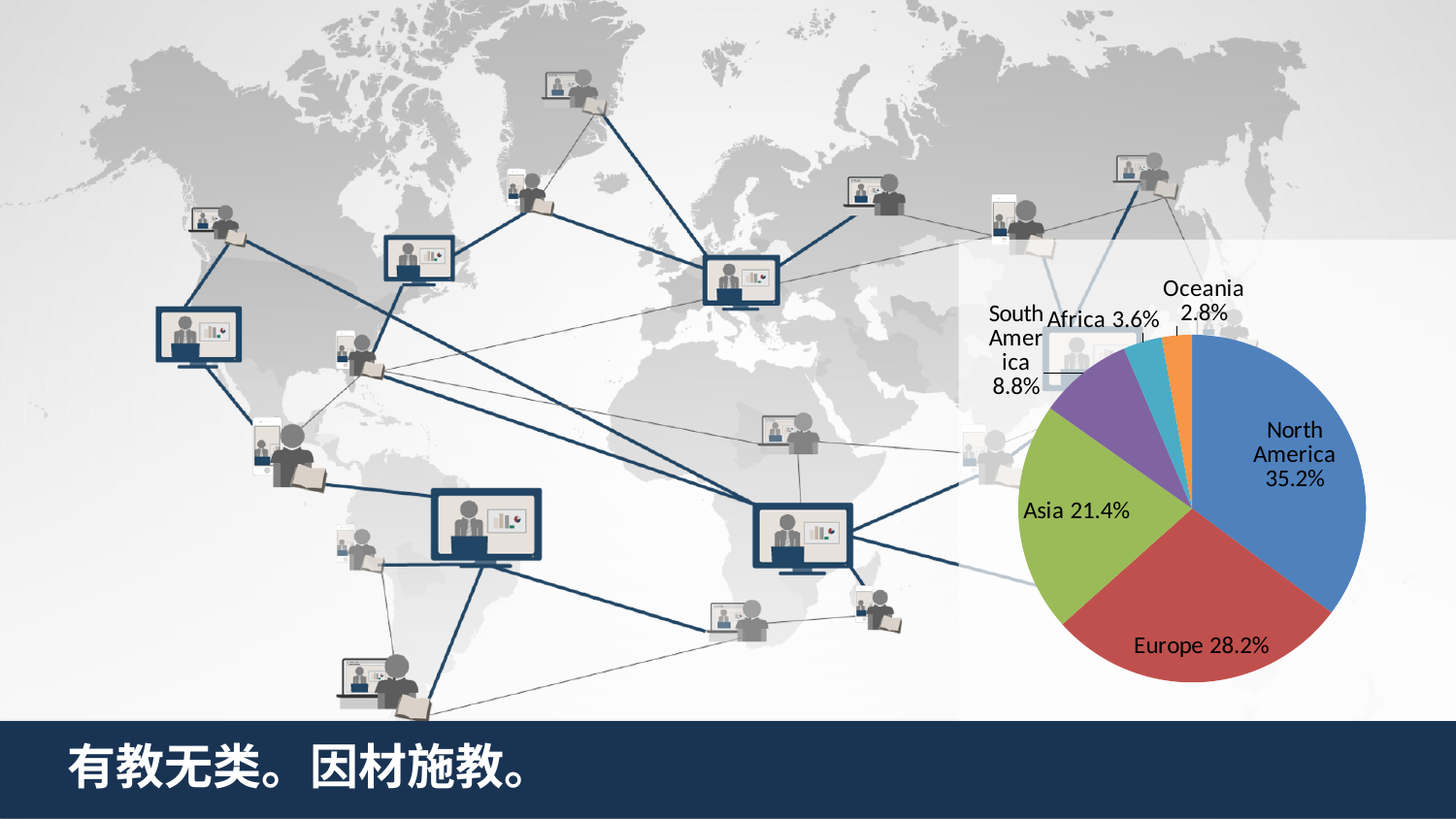
What is the share for Europe? 28.2% What is the share for Oceania? 2.8% Which is larger, the share for Asia or the share for Europe? Europe What is the difference between the shares of North America and Europe? 7.0% What is the share for North America? 35.2% Which region has the smallest slice of the pie? Oceania What is the share for South America? 8.8% What type of chart is shown on the slide? pie chart How many regions are shown in the pie chart? 6 What is the share for Africa? 3.6% What is the share for Asia? 21.4% Which region has the largest slice of the pie? North America